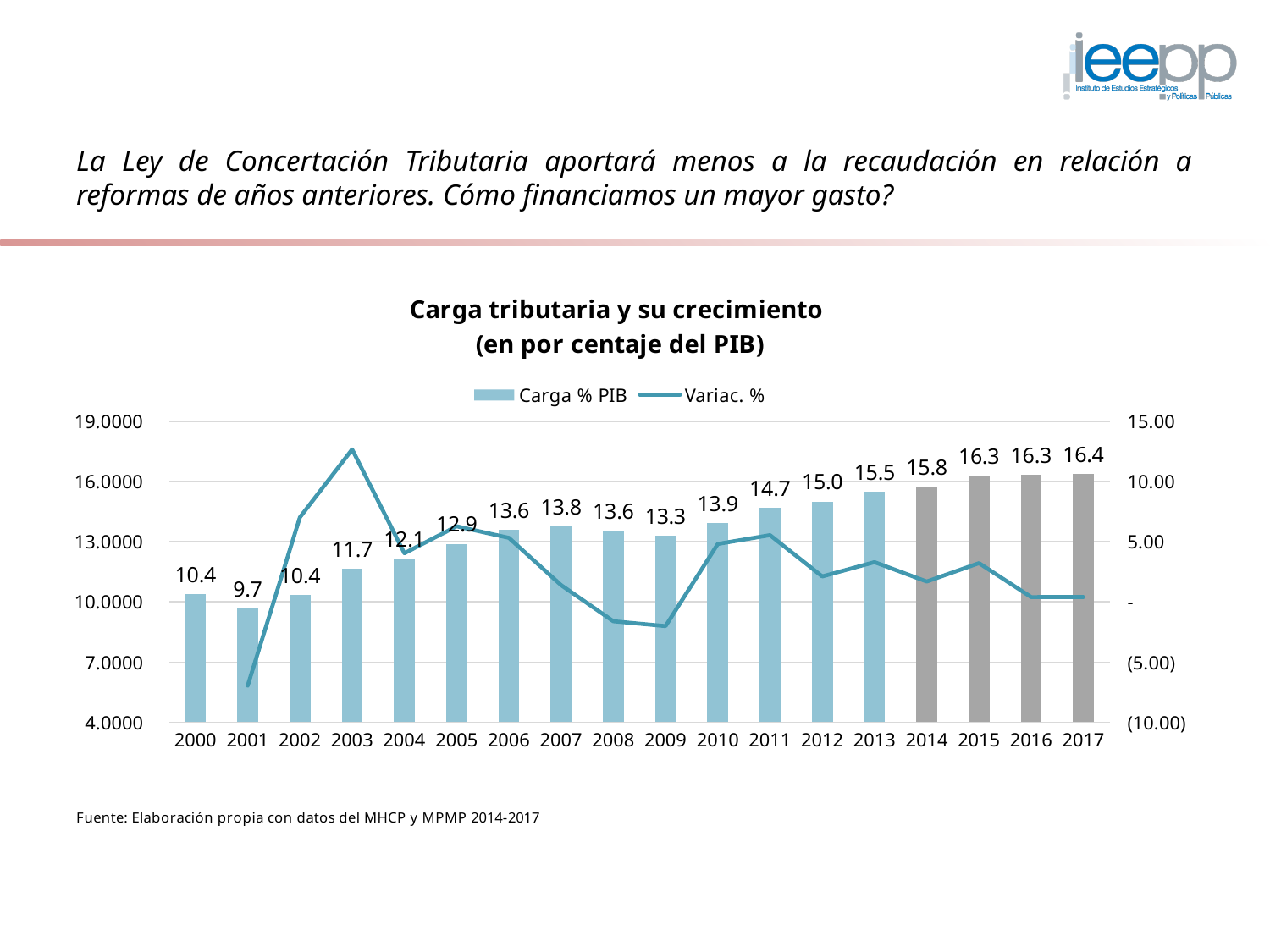
Do the Carga % PIB values generally rise or fall from 2000 to 2017? Rise How many years are shown on the x axis? 18 What kind of chart is shown on the slide? Combined bar and line chart Which year has a larger Carga % PIB value, 2009 or 2010? 2010 What is the Carga % PIB value for 2005? 12.9 Which year has the lowest Carga % PIB value? 2001 Is the Variac. % value for 2001 greater or less than (5.00) on the right axis? less What is the Carga % PIB value for 2011? 14.7 Which year has the highest Carga % PIB value? 2017 What is the difference between the Carga % PIB values for 2017 and 2000? 6.0 How many series does the legend list? 2 Is the Variac. % value for 2003 greater or less than 10.00 on the right axis? greater